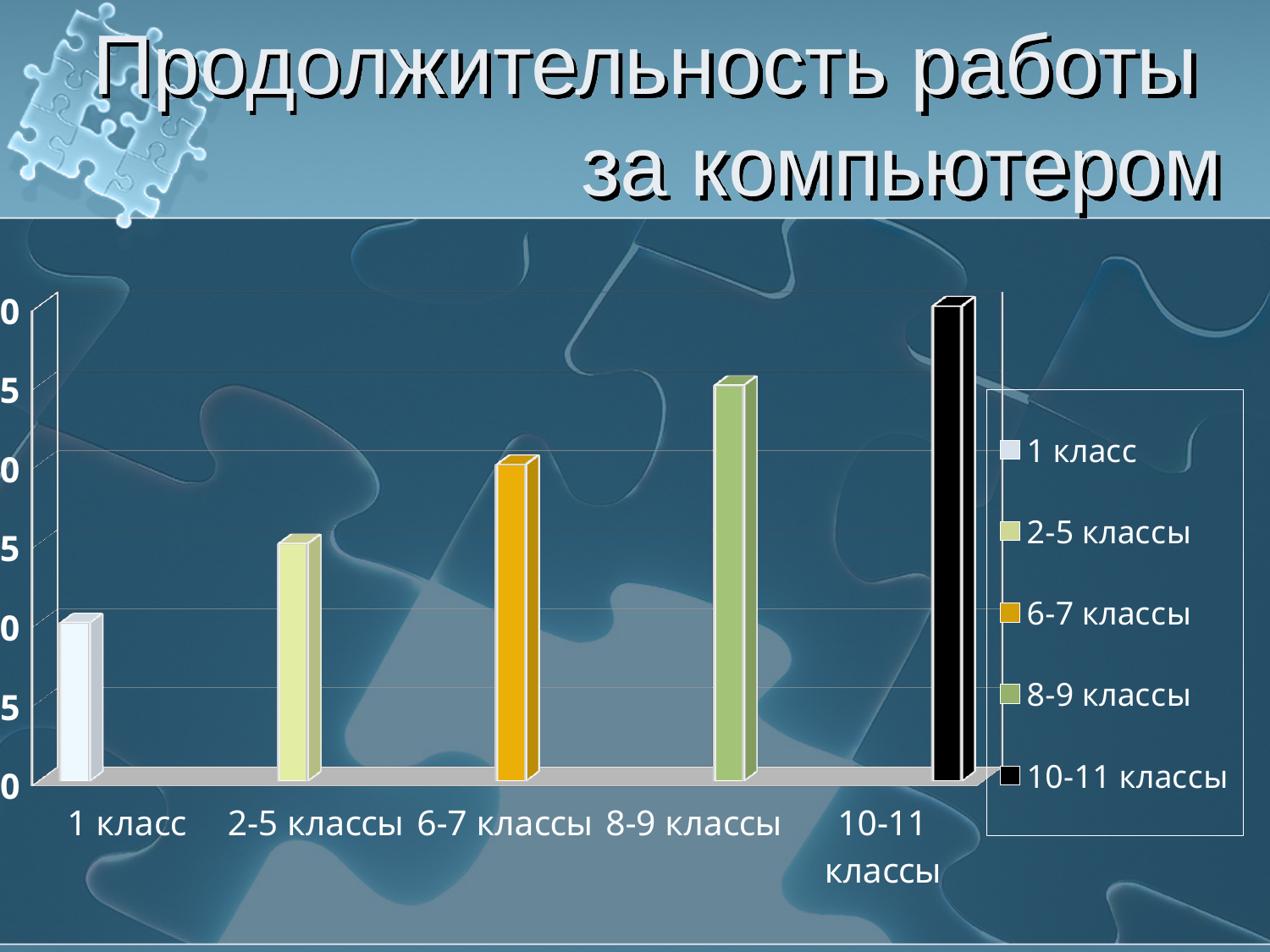
Which category has the highest bar in the chart? 10-11 классы How many categories are shown along the x axis of the chart? 5 Which category has the lowest bar in the chart? 1 класс Which is larger, the bar for 8-9 классы or the bar for 10-11 классы? 10-11 классы How many entries does the chart's legend list? 5 Do the bar values rise or fall from left to right along the x axis? rise What colour is the bar for 10-11 классы? black What is the title of the chart on the slide? Продолжительность работы за компьютером Which category is represented by the orange bar? 6-7 классы Which is larger, the bar for 6-7 классы or the bar for 2-5 классы? 6-7 классы What kind of chart is shown on the slide? bar chart